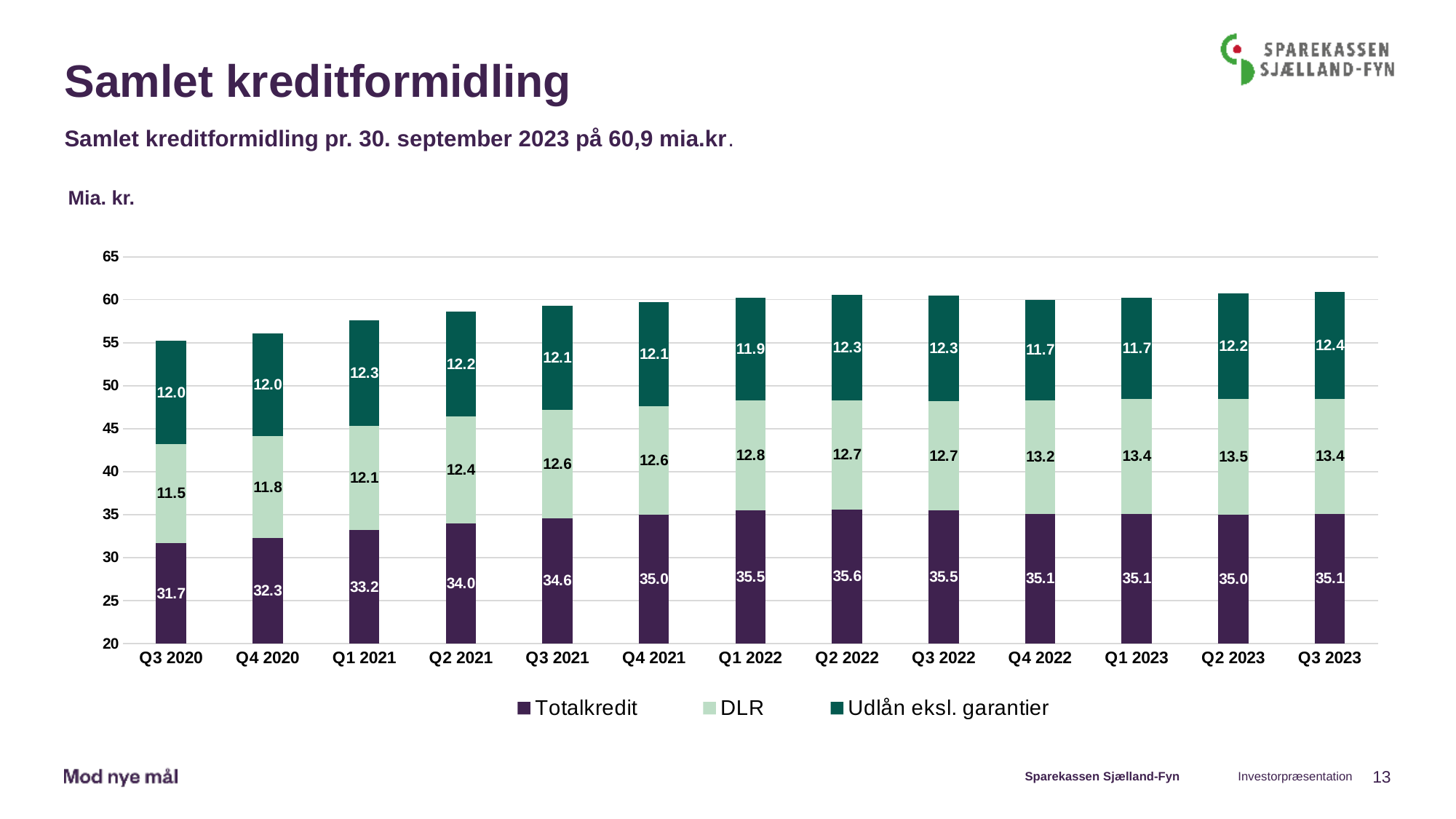
What is the DLR value for Q1 2021? 12.1 What is the Totalkredit value for Q3 2023? 35.1 In Q3 2023, which is larger: the DLR value or the Udlån eksl. garantier value? DLR How many series does the legend list? 3 In which quarter is the Udlån eksl. garantier value highest? Q3 2023 In which quarter is the Totalkredit value highest? Q2 2022 In which quarter is the DLR value lowest? Q3 2020 How many quarters are shown on the x axis? 13 What is the Udlån eksl. garantier value for Q4 2022? 11.7 What kind of chart is shown on the slide? Stacked bar chart What is the total of the stacked bar for Q3 2023? 60.9 What is the difference between the Totalkredit value in Q3 2023 and in Q3 2020? 3.4